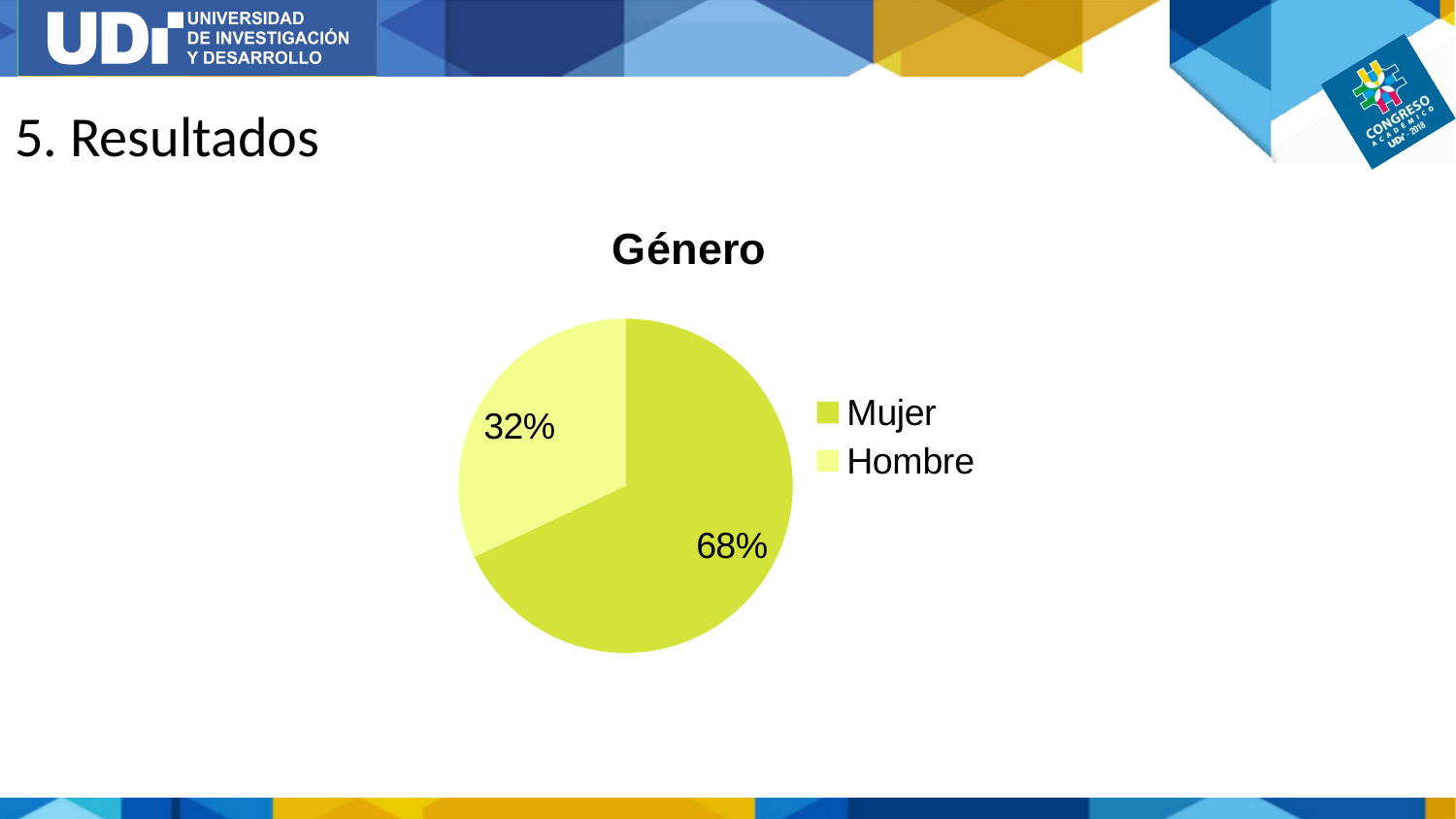
What share of the pie does Hombre represent? 32% Which category has the largest slice of the pie? Mujer What kind of chart is shown on the slide? pie chart Which category has the smallest slice of the pie? Hombre How many entries does the legend list? 2 Which slice is larger, Mujer or Hombre? Mujer What share of the pie does Mujer represent? 68% What is the title of the chart? Género What is the difference in percentage points between the Mujer and Hombre slices? 36 How many categories does the pie chart show? 2 Is the value for Hombre greater or less than 50%? less Which legend entry is shown in the lighter yellow colour? Hombre